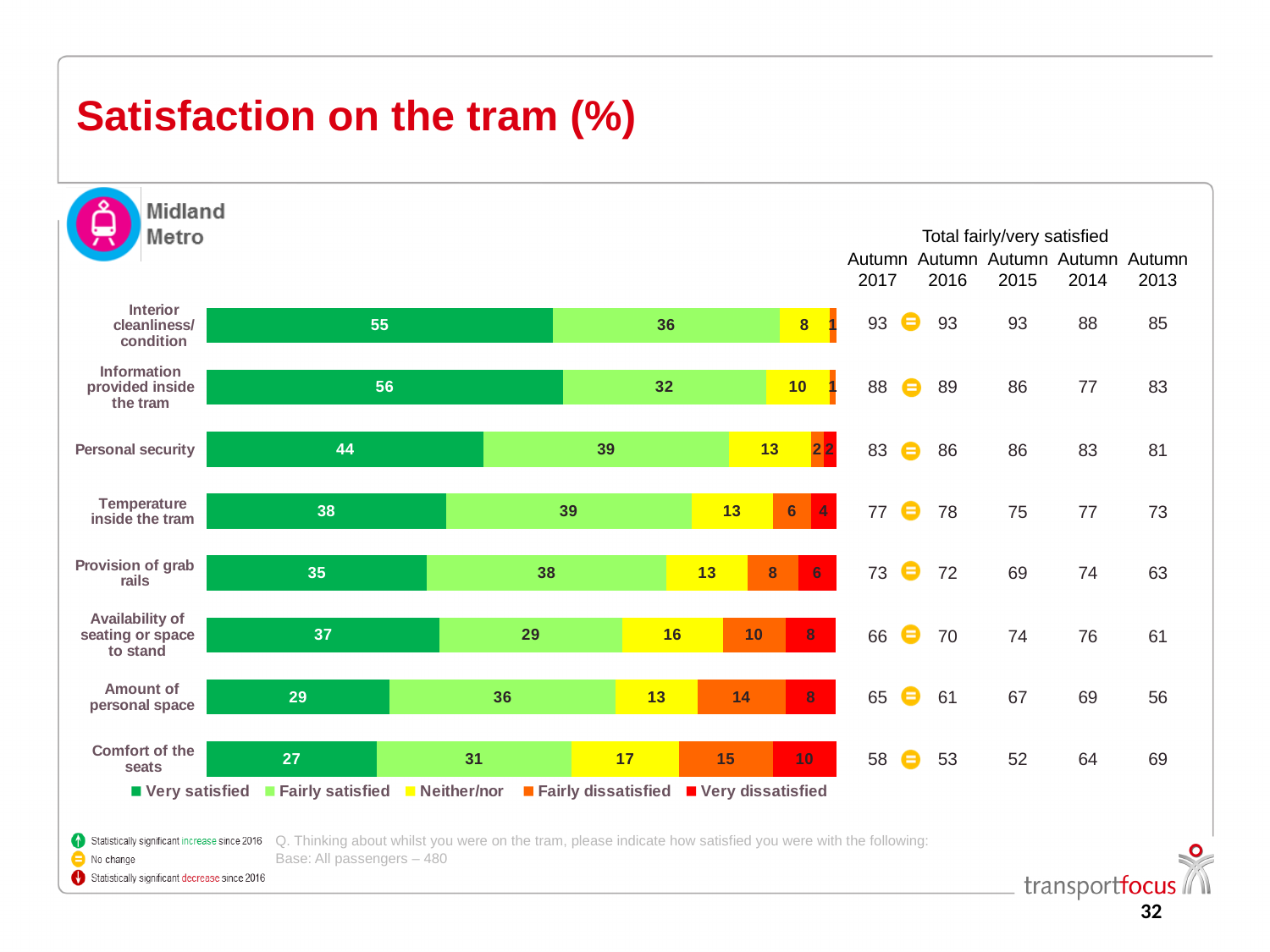
What is the difference between the Very satisfied values for Interior cleanliness/condition and Comfort of the seats? 28 Which category has the lowest Very satisfied value? Comfort of the seats What colour represents Very dissatisfied in the legend? Red What is the Very satisfied value for Personal security? 44 What is the combined Very satisfied and Fairly satisfied value for Provision of grab rails? 73 What is the Neither/nor value for Comfort of the seats? 17 Which has the larger Fairly satisfied value: Interior cleanliness/condition or Availability of seating or space to stand? Interior cleanliness/condition What is the Fairly dissatisfied value for Amount of personal space? 14 How many categories are shown in the bar chart? 8 How many series does the legend list? 5 Which category has the highest Very satisfied value? Information provided inside the tram What kind of chart is shown on the slide? Stacked bar chart